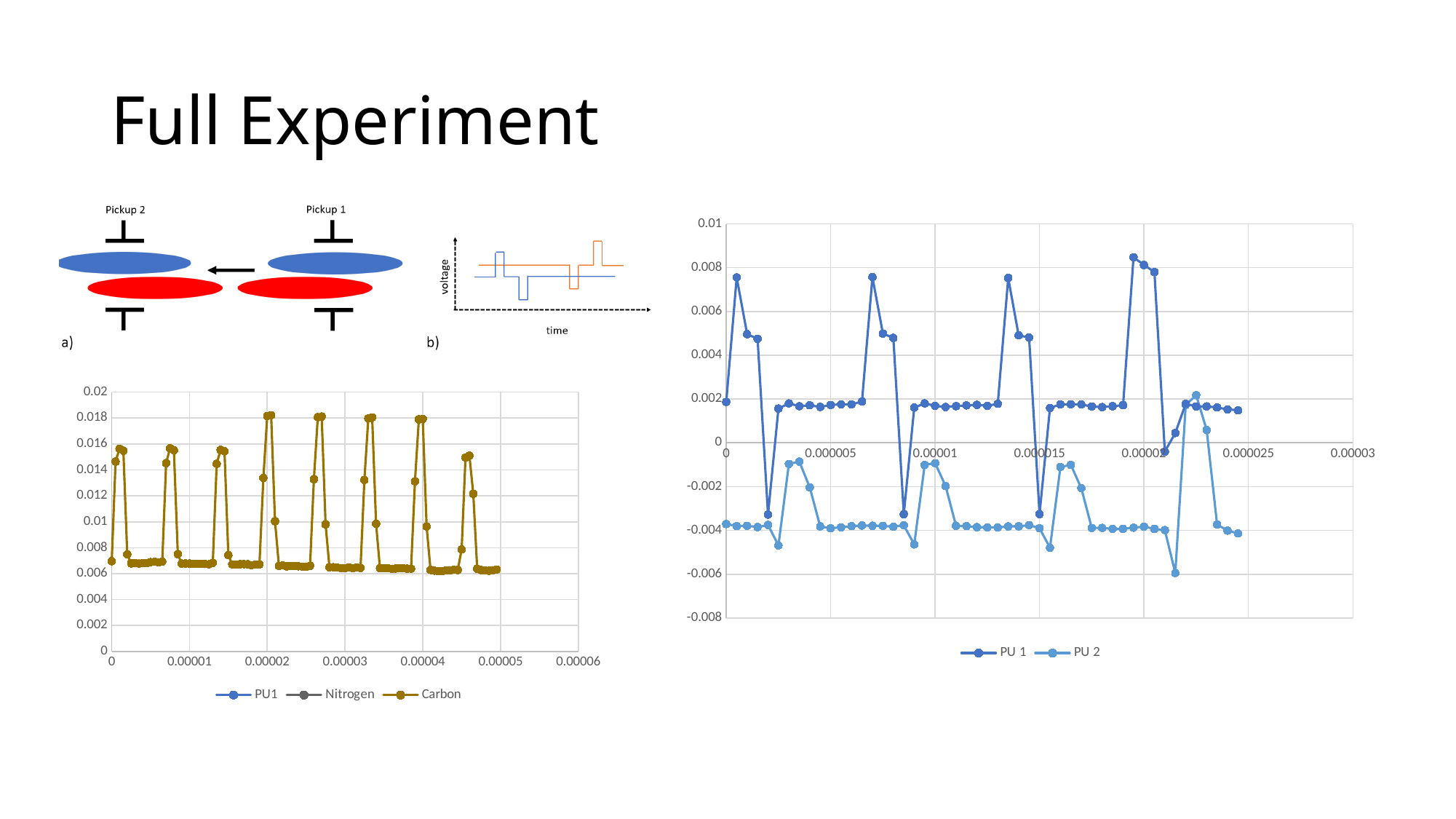
What kind of chart is the chart on the right of the slide? line chart In the right chart, is the lowest value of the PU 2 series greater or less than -0.004? less What is the maximum value shown on the y axis of the left chart? 0.02 How many series does the legend of the right chart list? 2 How many series does the legend of the left chart list? 3 In the right chart, which series reaches the lowest value, PU 1 or PU 2? PU 2 In the left chart, is the baseline level of the Carbon series between peaks greater or less than 0.008? less In the right chart, which series reaches the highest value, PU 1 or PU 2? PU 1 What are the series names in the legend of the left chart? PU1, Nitrogen, Carbon In the left chart, is the highest peak of the Carbon series greater or less than 0.016? greater What kind of chart is the chart on the left of the slide? line chart